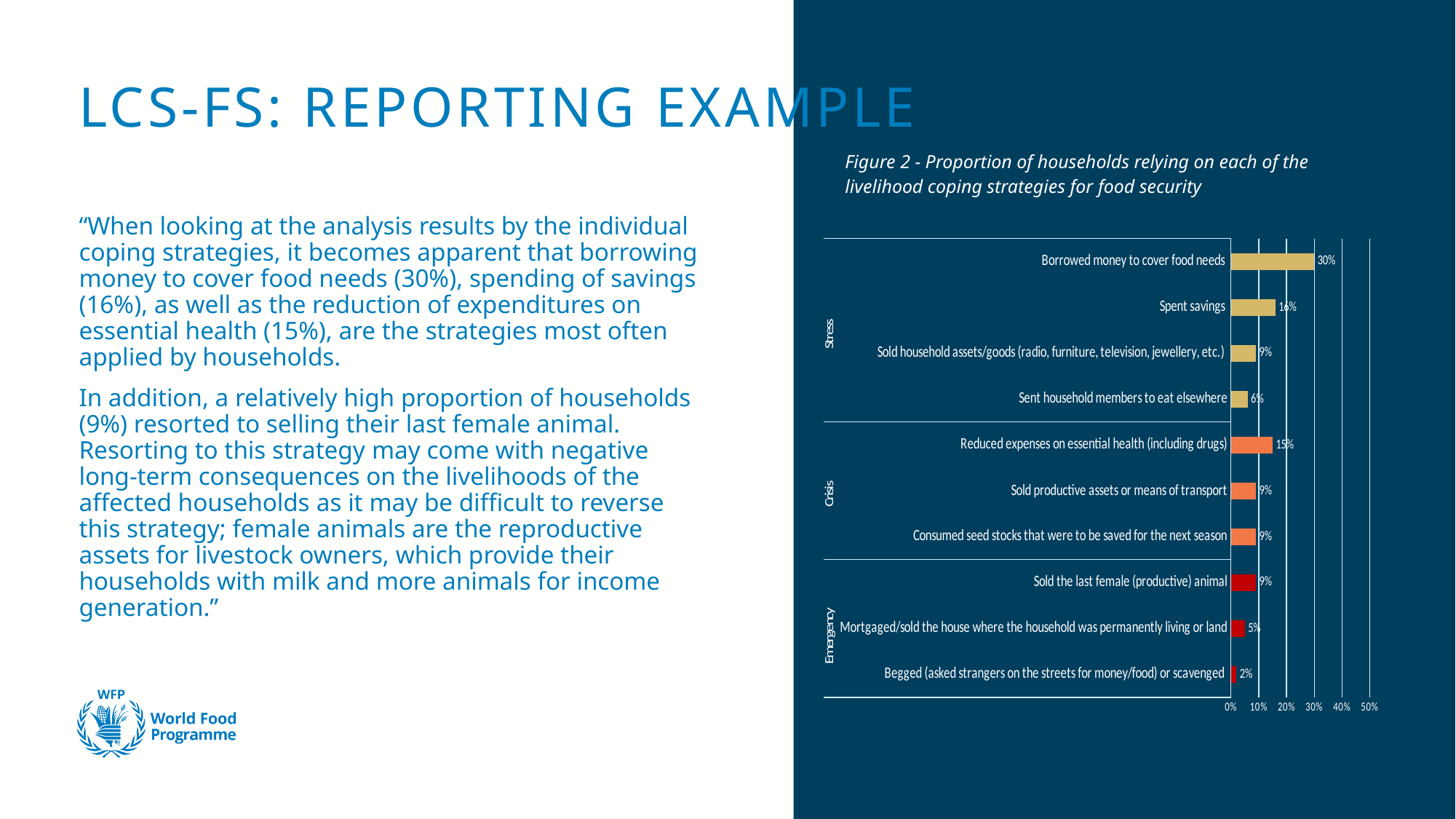
Which is larger: the value for 'Sent household members to eat elsewhere' or 'Mortgaged/sold the house where the household was permanently living or lived'? Sent household members to eat elsewhere Which coping strategy has the lowest proportion of households? Begged (asked strangers on the streets for money/food) or scavenged How many coping strategies are plotted in the chart? 10 What is the value for 'Spent savings'? 16% What is the value for 'Begged (asked strangers on the streets for money/food) or scavenged'? 2% What proportion of households reduced expenses on essential health (including drugs)? 15% What type of chart is shown on the slide? bar chart What are the three groups the coping strategies are divided into on the chart's vertical axis? Stress, Crisis, Emergency Is the value for 'Reduced expenses on essential health (including drugs)' greater or less than 10%? greater Which coping strategy has the highest proportion of households? Borrowed money to cover food needs What percentage of households borrowed money to cover food needs? 30% What is the difference between the value for 'Borrowed money to cover food needs' and 'Spent savings'? 14%